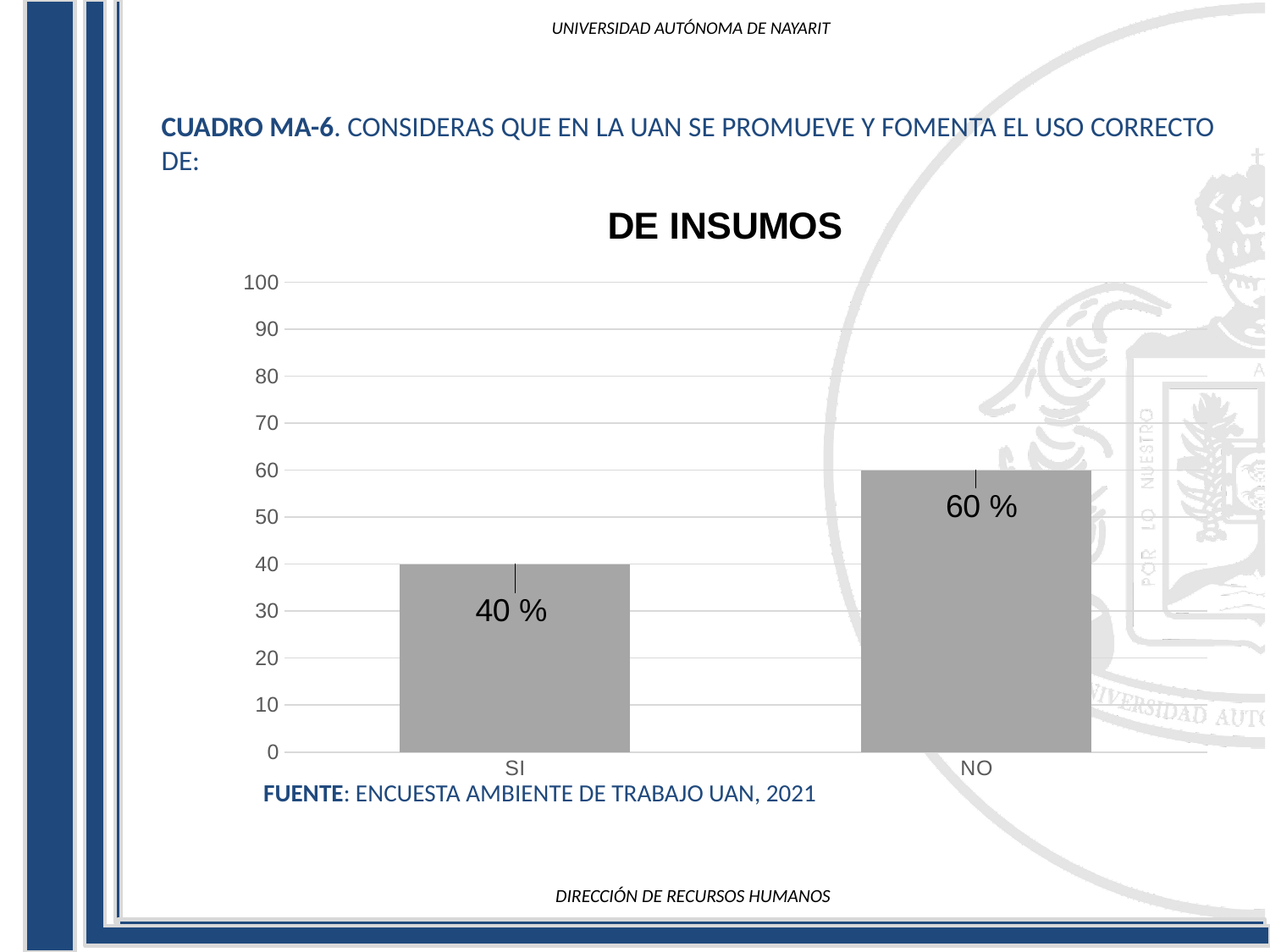
Which category has the highest value in the DE INSUMOS chart? NO Which category has the lowest value in the DE INSUMOS chart? SI What kind of chart is the DE INSUMOS chart? bar chart What is the title of the chart on the slide? DE INSUMOS What is the maximum value shown on the vertical axis of the DE INSUMOS chart? 100 What is the value for SI in the DE INSUMOS chart? 40 % What is the value for NO in the DE INSUMOS chart? 60 % How many categories are shown in the DE INSUMOS chart? 2 Is the value for SI greater or less than 50 in the DE INSUMOS chart? less Is the value for NO greater or less than 50 in the DE INSUMOS chart? greater What is the difference between the values for NO and SI in the DE INSUMOS chart? 20 % Which is larger in the DE INSUMOS chart, the value for SI or the value for NO? NO